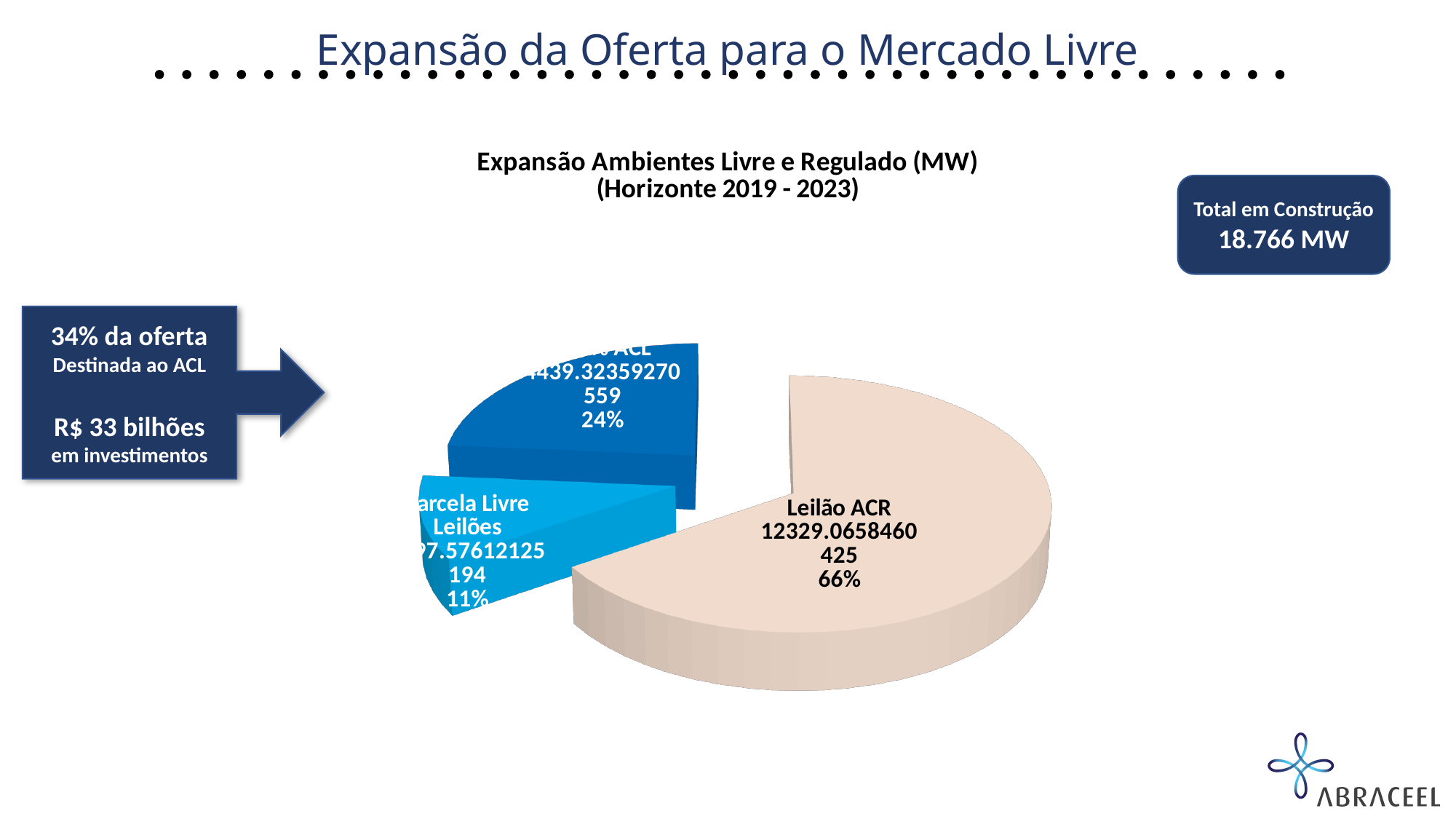
Which slice of the pie chart is the smallest? Parcela Livre Leilões What share of the pie does the Parcela Livre Leilões slice represent? 11% How many slices does the pie chart have? 3 What share of the pie does the Leilão ACR slice represent? 66% Which slice is larger, Leilão ACR or Parcela Livre Leilões? Leilão ACR What colour is the Leilão ACR slice in the pie chart? beige What is the title of the pie chart? Expansão Ambientes Livre e Regulado (MW) (Horizonte 2019 - 2023) Which slice of the pie chart is the largest? Leilão ACR By how many percentage points does the Leilão ACR share exceed the Parcela Livre Leilões share? 55 percentage points Is the share of the Leilão ACR slice greater or less than 50%? greater What kind of chart is shown on the slide? pie chart